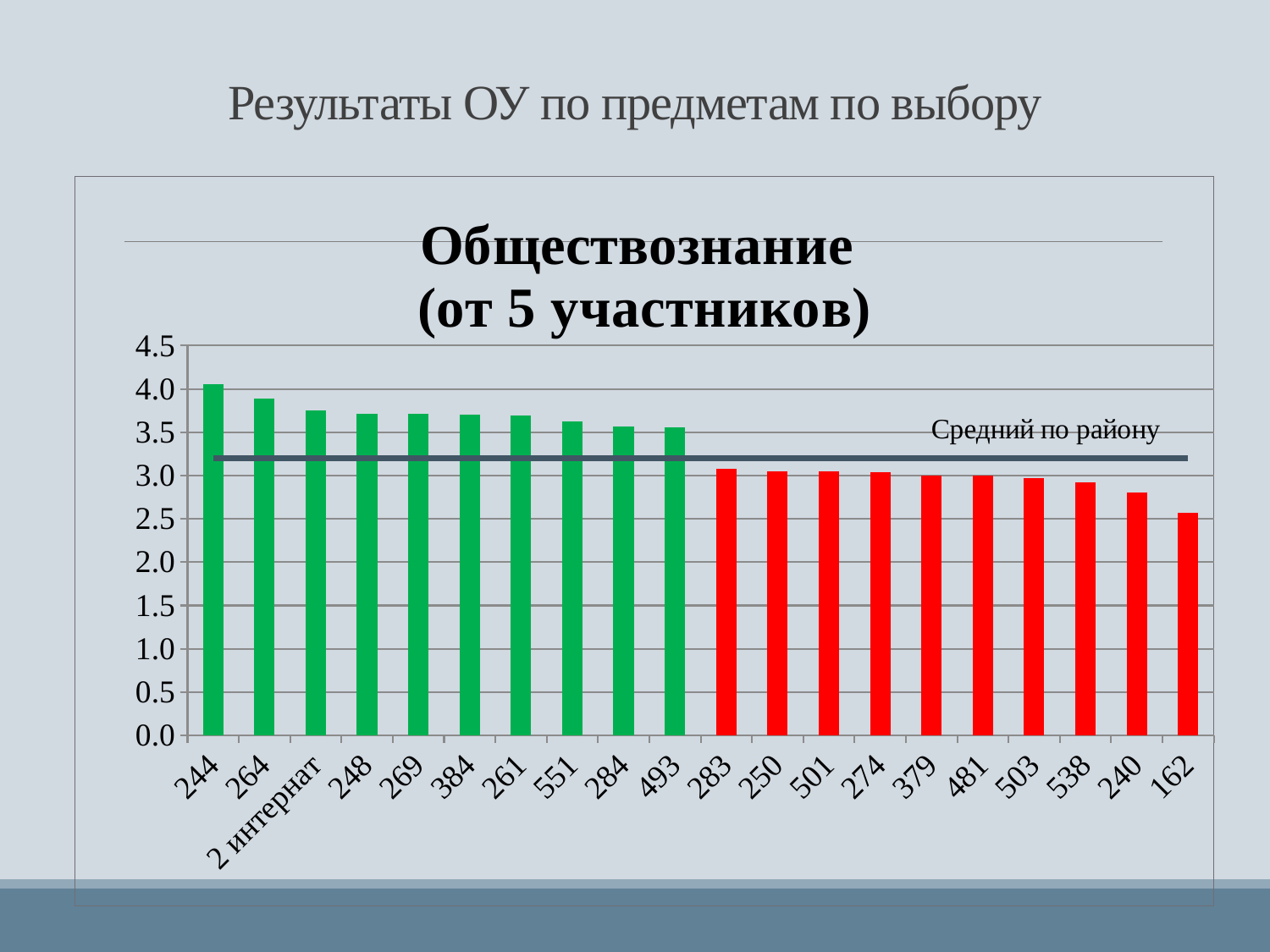
What kind of chart is shown on the slide? bar chart Is the value for 264 greater or less than 3.5? greater Do the bar values rise or fall from left to right along the x axis? fall Which category has the highest bar in the chart? 244 Which category has the lowest bar in the chart? 162 What is the title of the chart? Обществознание (от 5 участников) How many categories (bars) are plotted in the chart? 20 Is the value for 2 интернат greater or less than 3.5? greater Is the value for 240 greater or less than 3.0? less Which has the larger value, 244 or 162? 244 What is the label of the horizontal line drawn across the chart? Средний по району